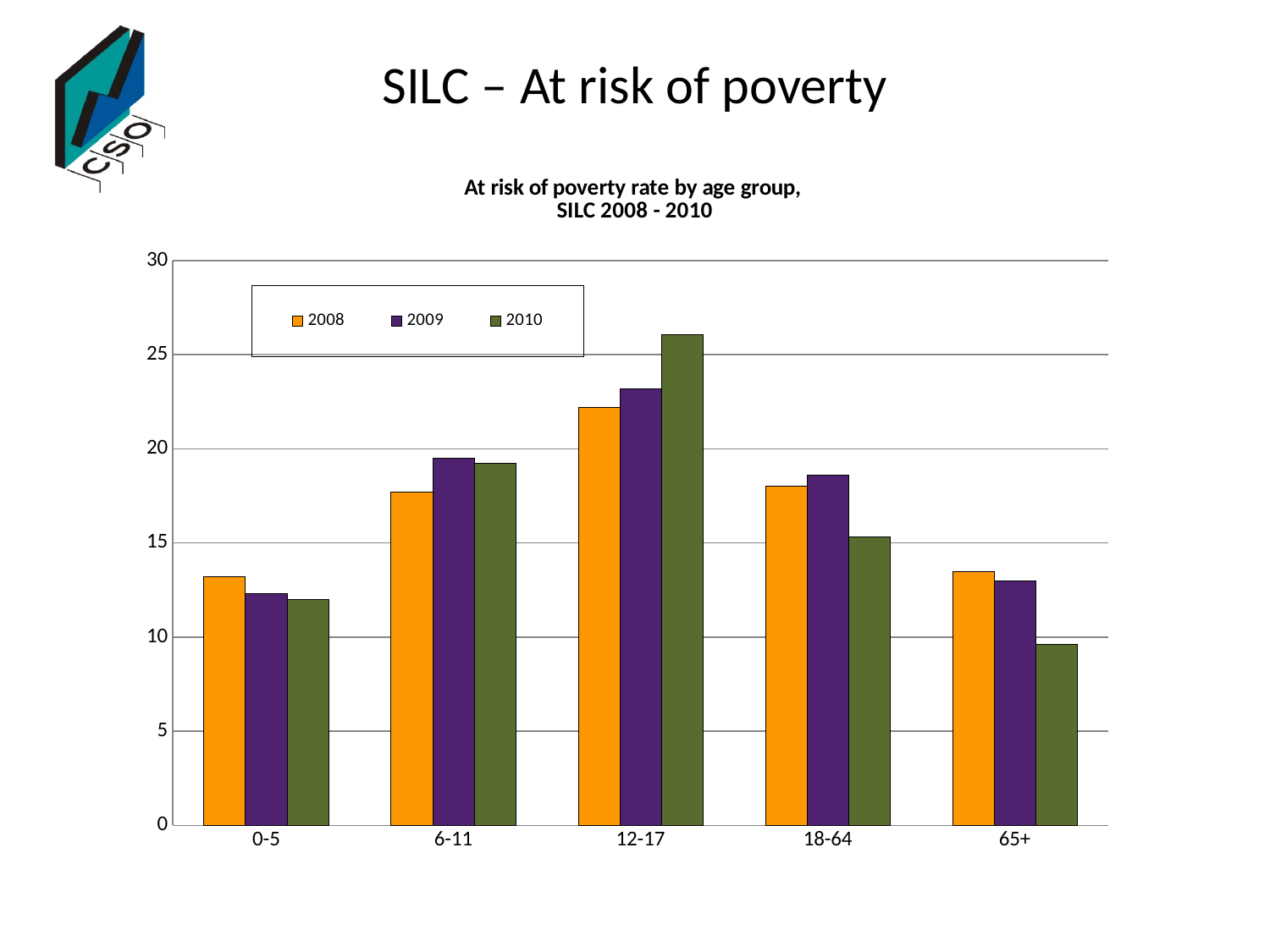
How many age groups are shown on the x axis? 5 Is the 2010 value for the 65+ age group greater or less than 10? less Which age group has the highest at risk of poverty rate for 2008? 12-17 Is the 2010 value for the 12-17 age group greater or less than 25? greater For the 0-5 age group, which is larger, the 2008 value or the 2010 value? 2008 Which age group has the highest at risk of poverty rate for 2010? 12-17 What kind of chart is shown on the slide? bar chart What is the title of the chart? At risk of poverty rate by age group, SILC 2008 - 2010 For the 18-64 age group, which is larger, the 2009 value or the 2010 value? 2009 Which age group has the lowest at risk of poverty rate for 2010? 65+ How many series does the legend list? 3 Is the 2008 value for the 6-11 age group greater or less than 15? greater